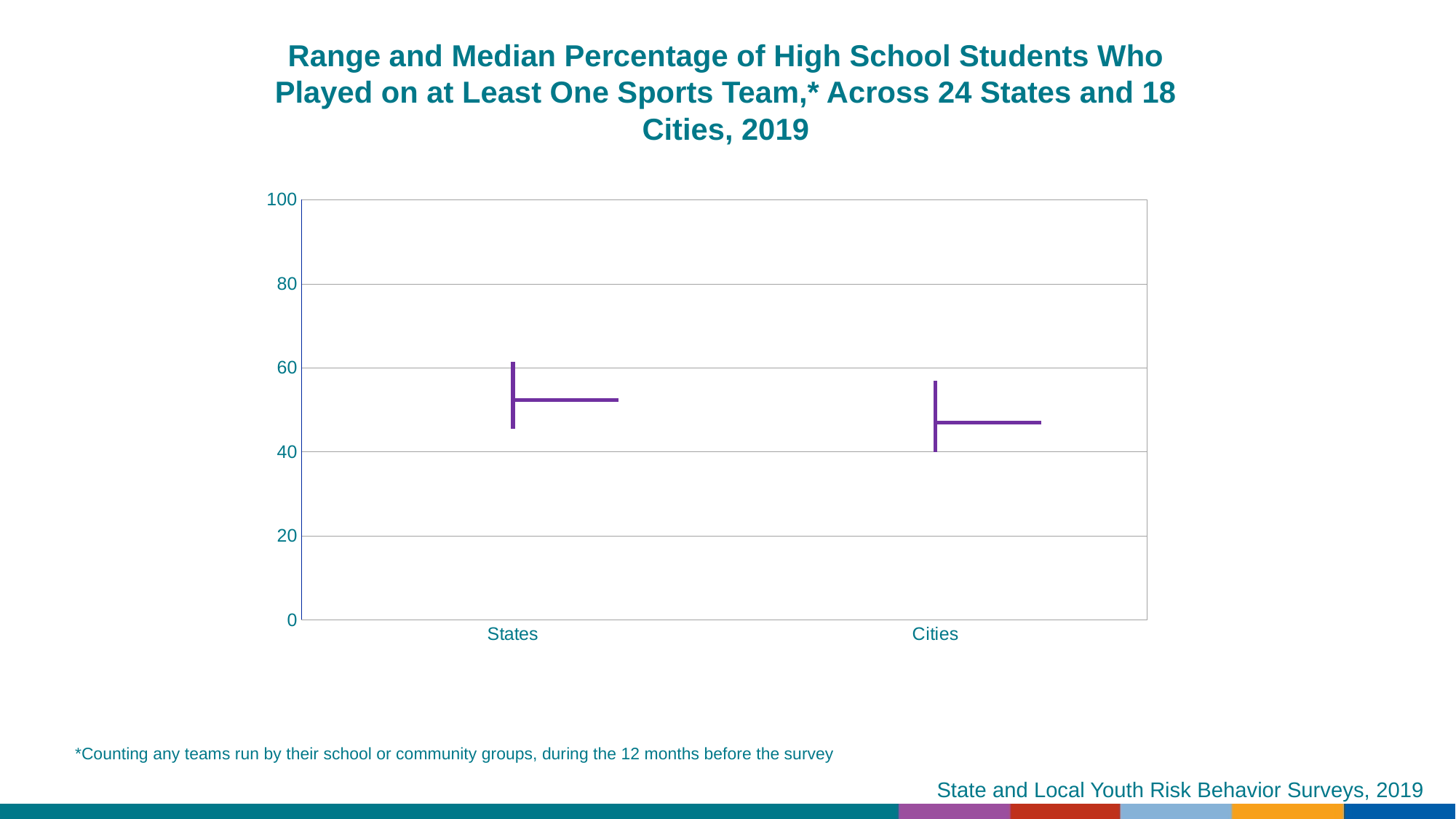
Is the highest value in the Cities range greater or less than 60? less Is the median value for Cities greater or less than 20? greater Is the median value for States greater or less than 40? greater Which category has the higher median percentage, States or Cities? States What kind of chart is shown on the slide? A range and median (high-low) chart How many categories are shown on the x axis of the chart? 2 Which category has the higher top of its range, States or Cities? States What are the two categories shown on the x axis? States and Cities What is the maximum value shown on the y axis of the chart? 100